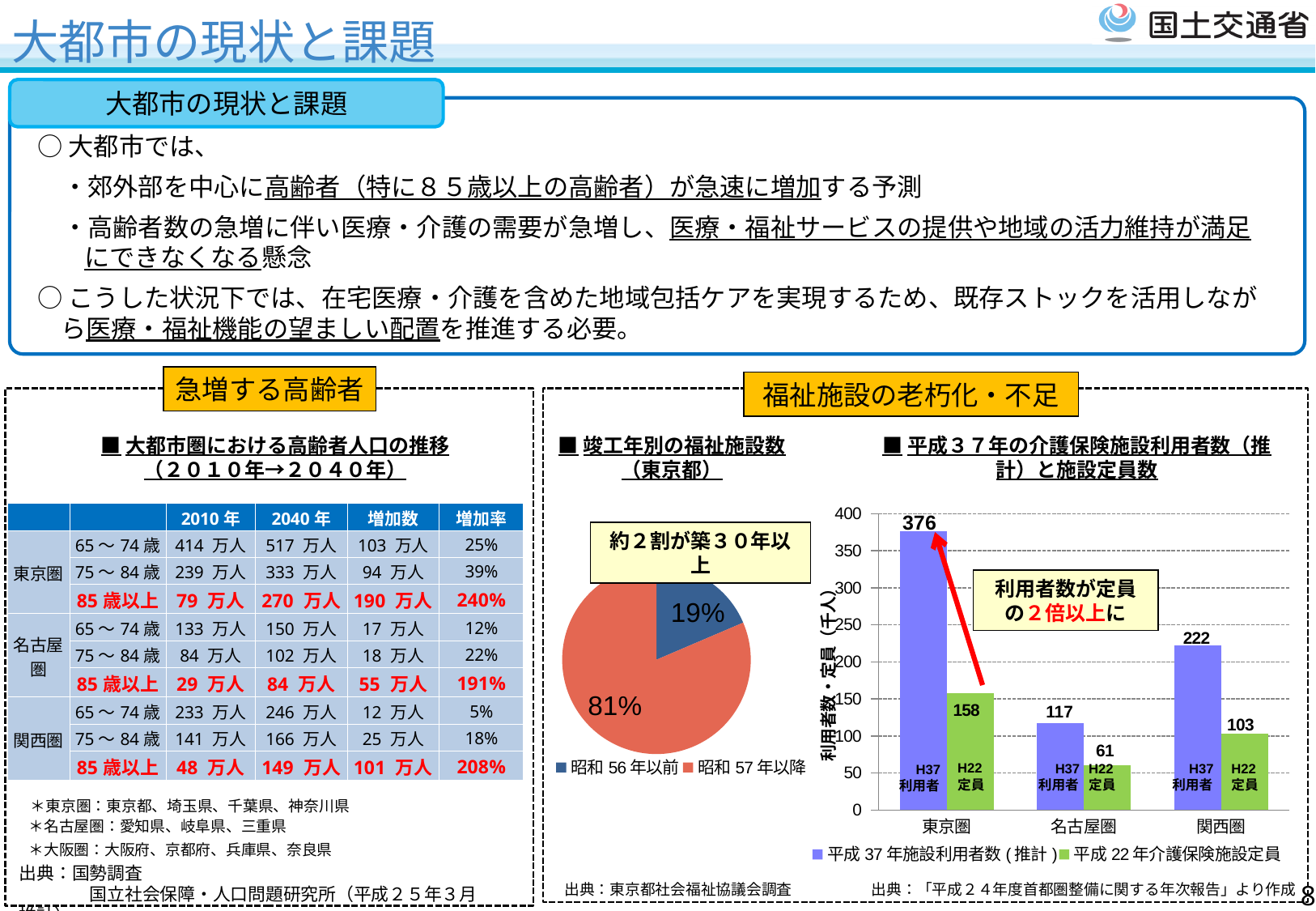
In the bar chart titled 平成３７年の介護保険施設利用者数（推計）と施設定員数, how many series does the legend list? 2 In the bar chart titled 平成３７年の介護保険施設利用者数（推計）と施設定員数, what is the value of 平成22年介護保険施設定員 for 名古屋圏? 61 In the bar chart titled 平成３７年の介護保険施設利用者数（推計）と施設定員数, what is the value of 平成37年施設利用者数(推計) for 東京圏? 376 In the bar chart titled 平成３７年の介護保険施設利用者数（推計）と施設定員数, what is the difference between 平成37年施設利用者数(推計) and 平成22年介護保険施設定員 for 東京圏? 218 In the pie chart titled 竣工年別の福祉施設数（東京都）, what share of facilities is 昭和57年以降? 81% In the pie chart titled 竣工年別の福祉施設数（東京都）, what share of facilities is 昭和56年以前? 19% In the bar chart titled 平成３７年の介護保険施設利用者数（推計）と施設定員数, what kind of chart is it? bar chart In the pie chart titled 竣工年別の福祉施設数（東京都）, how many slices are there? 2 In the bar chart titled 平成３７年の介護保険施設利用者数（推計）と施設定員数, which region has the lowest 平成22年介護保険施設定員? 名古屋圏 In the bar chart titled 平成３７年の介護保険施設利用者数（推計）と施設定員数, which region has the highest 平成37年施設利用者数(推計)? 東京圏 What kind of chart is the chart titled 竣工年別の福祉施設数（東京都）? pie chart In the bar chart titled 平成３７年の介護保険施設利用者数（推計）と施設定員数, what is the value of 平成22年介護保険施設定員 for 関西圏? 103